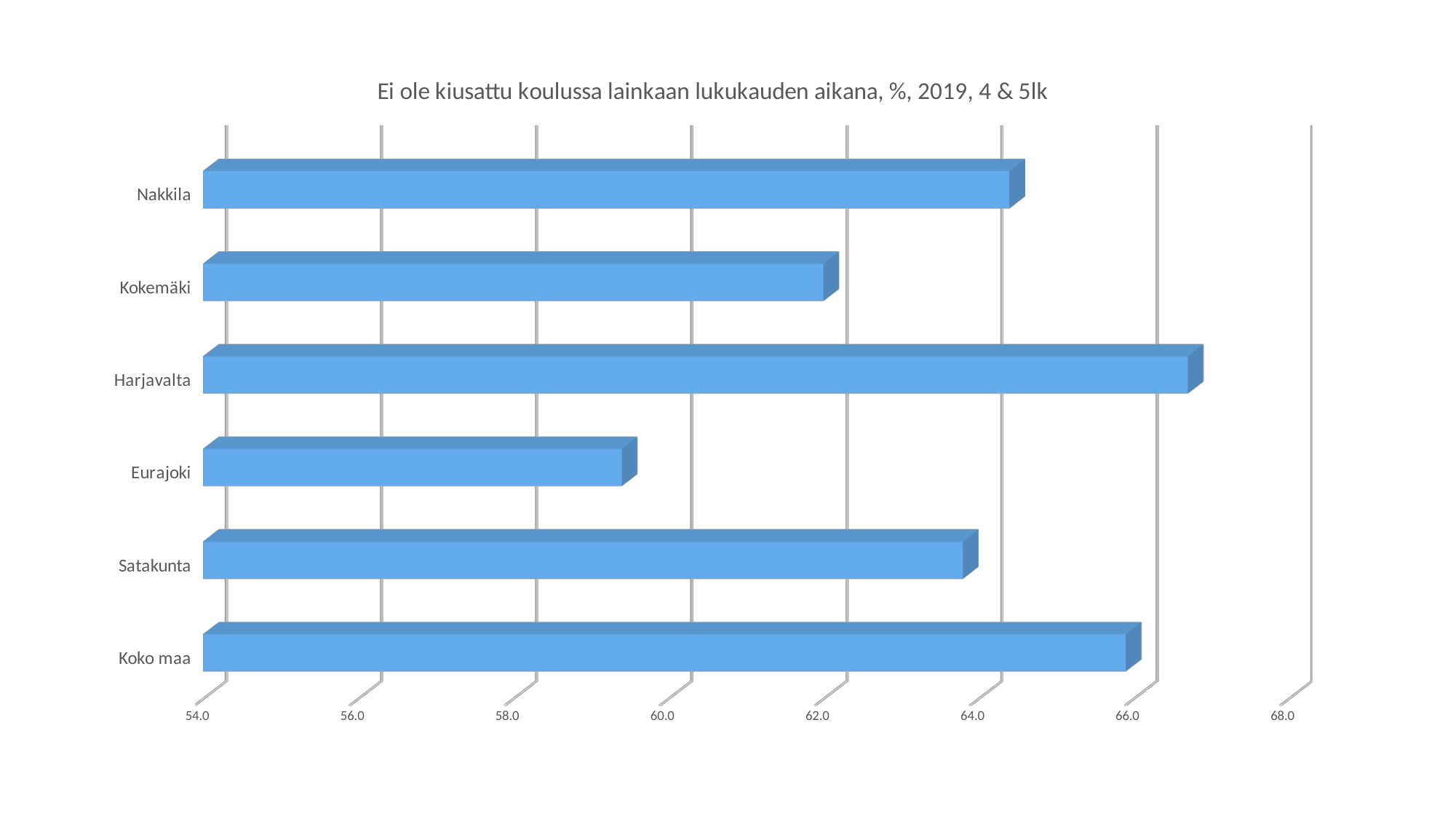
Is the value for Harjavalta greater or less than 66.0? greater Which has a larger value, Nakkila or Kokemäki? Nakkila Is the value for Eurajoki greater or less than 60.0? less What is the title of the chart? Ei ole kiusattu koulussa lainkaan lukukauden aikana, %, 2019, 4 & 5lk Is the value for Nakkila greater or less than 64.0? greater What kind of chart is shown on the slide? bar chart Which has a larger value, Koko maa or Satakunta? Koko maa Which category has the lowest value? Eurajoki How many categories are plotted in the chart? 6 Which category has the highest value? Harjavalta